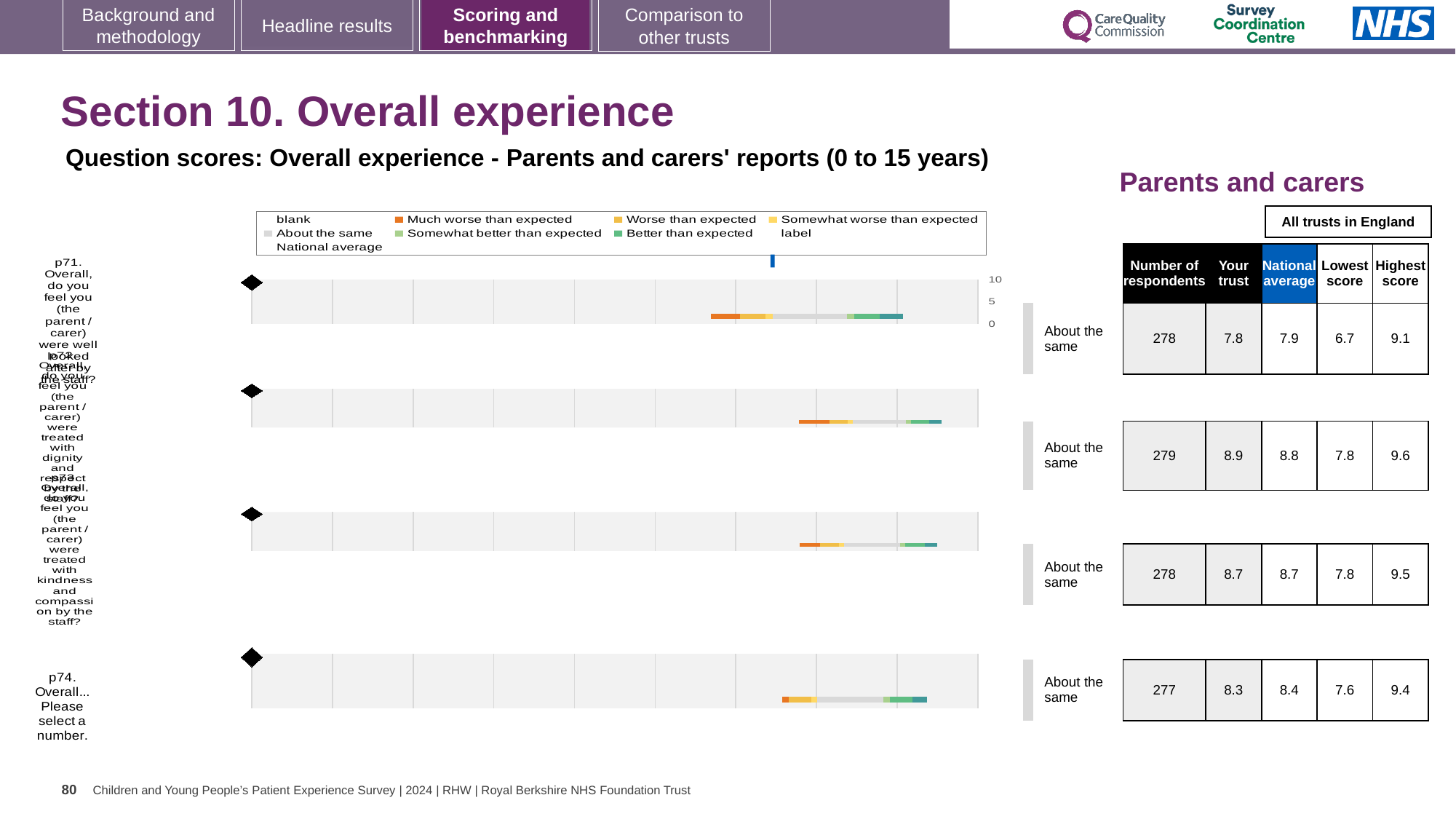
What kind of chart is shown on the slide? bar chart Which question row has the highest 'Your trust' score? p72 (8.9) What benchmark category is shown for all four question rows? About the same Which question row has the lowest 'Your trust' score? p71 (7.8) What is the 'Your trust' score for p71 (Overall, do you feel you were well looked after by the staff?)? 7.8 What is the number of respondents for p71? 278 What is the 'Your trust' score for p74 (Overall... Please select a number)? 8.3 For p74, is the 'Your trust' score (8.3) larger or smaller than the national average (8.4)? smaller What is the national average for p74? 8.4 How many question rows (bars) are plotted in the chart? 4 How many entries does the chart legend list? 9 What is the difference between the highest score (9.1) and the lowest score (6.7) for p71? 2.4